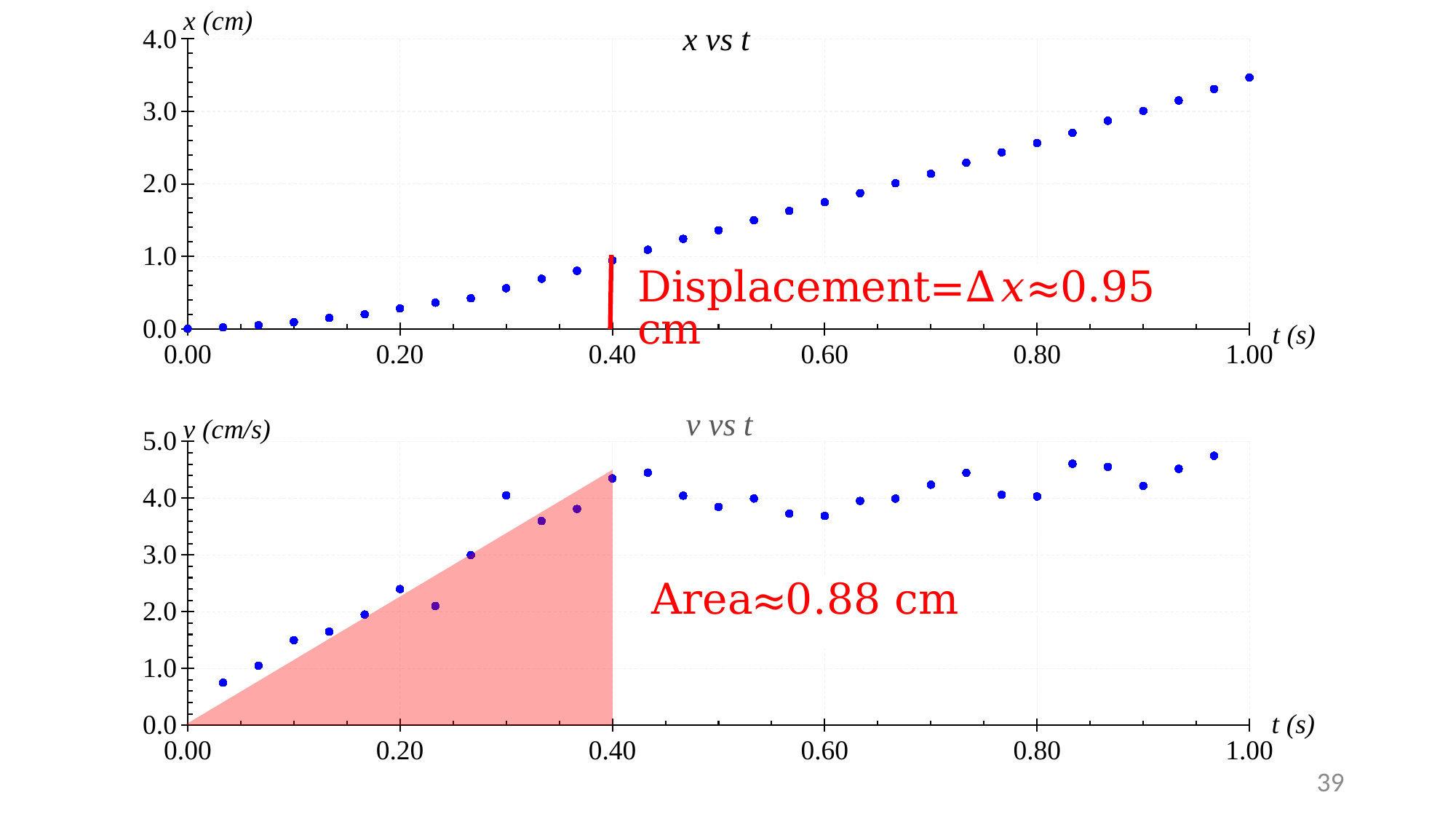
In the 'v vs t' chart, is the value at t = 0.40 s greater or less than 4.0? greater In the 'v vs t' chart, is the value at t = 0.60 s greater or less than 4.0? less In the 'x vs t' chart, at which value of t is x highest? 1.00 In the 'x vs t' chart, is the value at t = 0.20 s greater or less than 1.0? less In the 'v vs t' chart, is the value at t = 0.20 s larger or smaller than the value at t = 0.40 s? smaller In the 'x vs t' chart, at which value of t is x lowest? 0.00 What displacement value is annotated on the 'x vs t' chart? ≈0.95 cm What area value is annotated for the shaded region on the 'v vs t' chart? ≈0.88 cm What kind of chart is the 'x vs t' chart at the top of the slide? scatter chart In the 'x vs t' chart, do the values rise or fall as t increases? rise